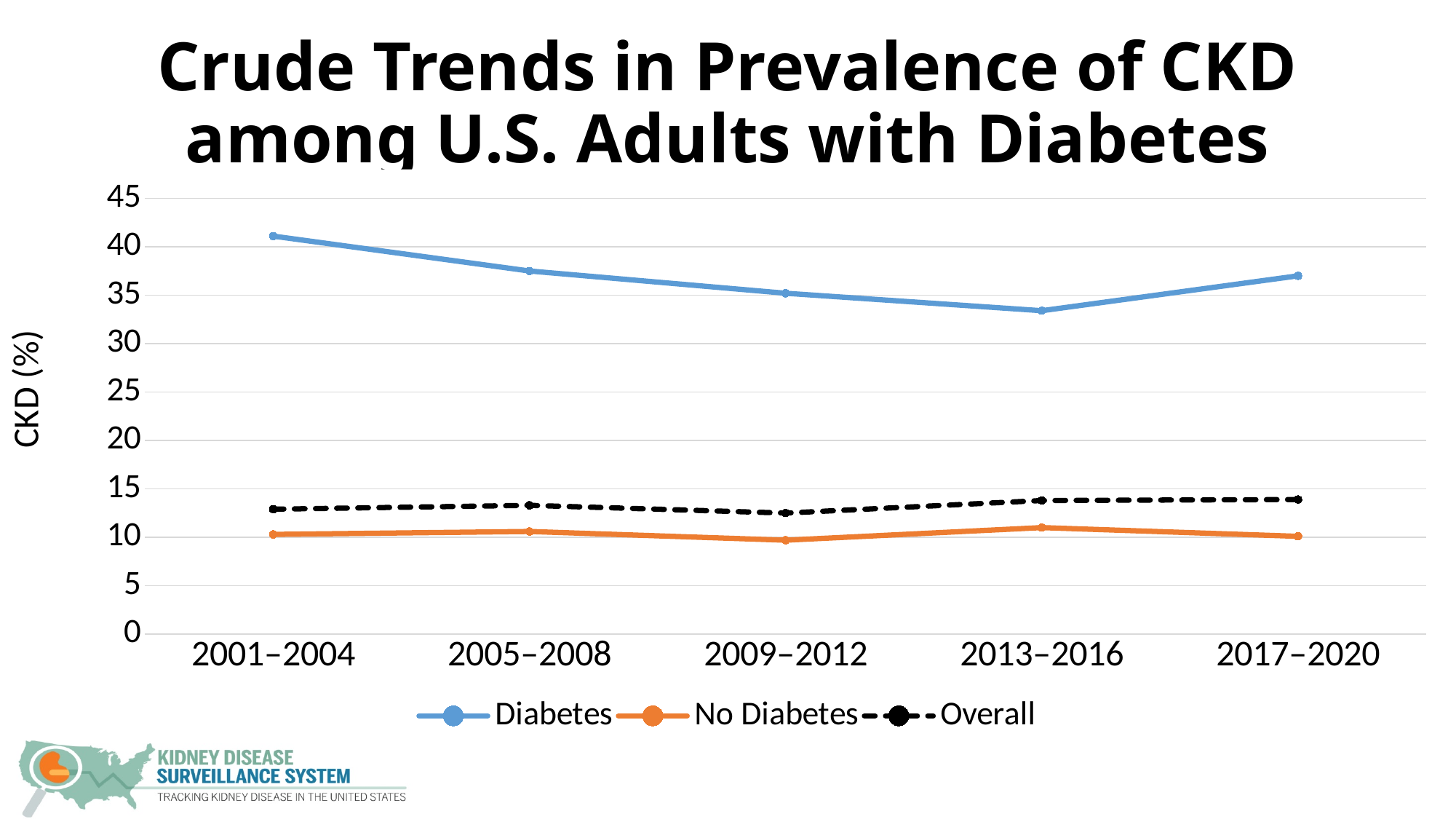
Is the value for Diabetes in 2001–2004 greater or less than 40? greater In which period is the Diabetes series highest? 2001–2004 In which period is the No Diabetes series lowest? 2009–2012 How many series does the legend list? 3 Which is larger in 2017–2020, the Diabetes value or the Overall value? Diabetes In which period is the Diabetes series lowest? 2013–2016 Is the value for Diabetes in 2013–2016 greater or less than 35? less What is the label on the y axis? CKD (%) How many time periods are shown on the x axis? 5 Does the Diabetes series rise or fall from 2001–2004 to 2013–2016? fall What kind of chart is shown on the slide? line chart